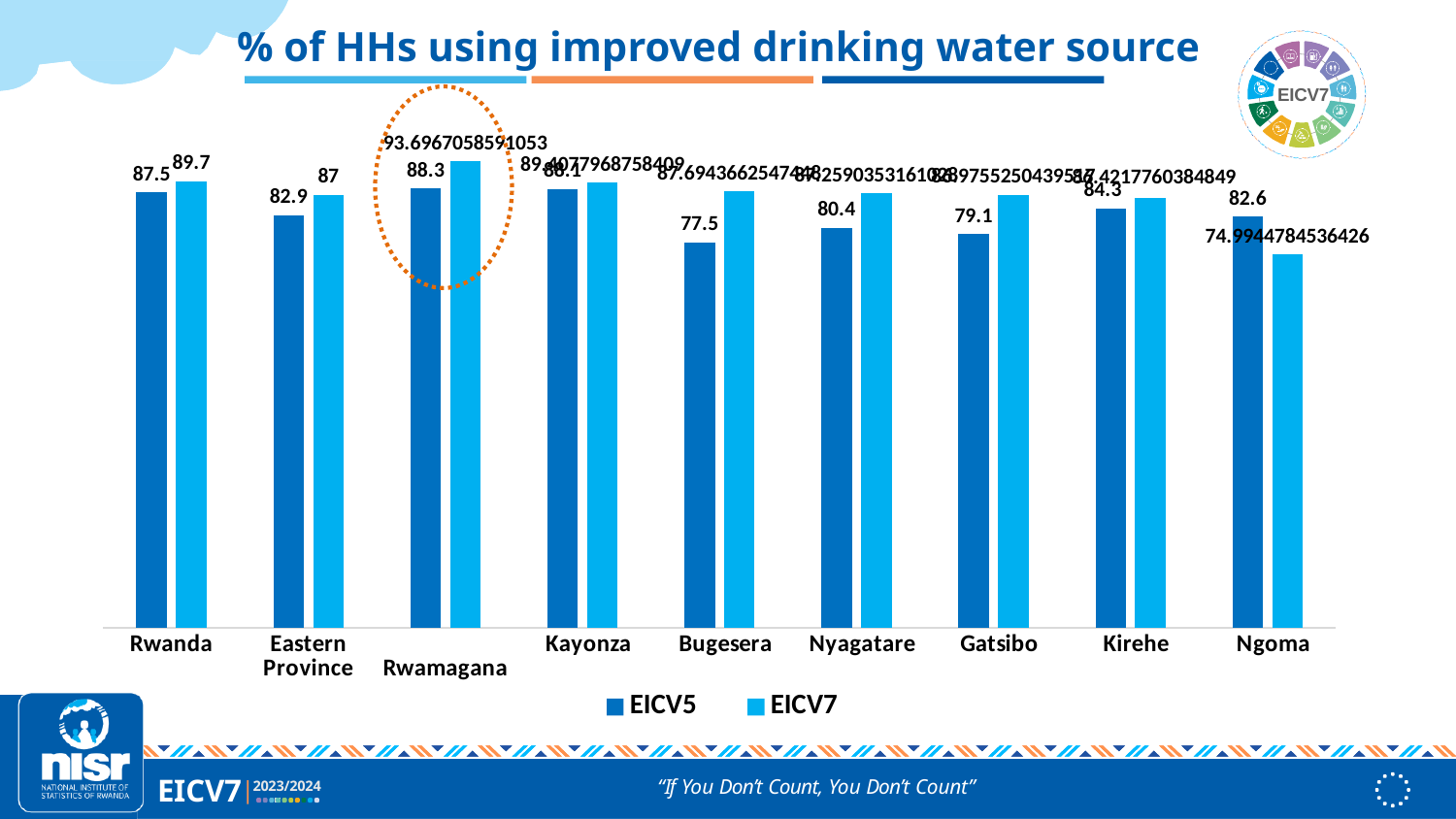
For Ngoma, which is larger: the EICV5 value or the EICV7 value? EICV5 Which category has the highest EICV7 value? Rwamagana What is the EICV7 value for Rwamagana? 93.6967058591053 How many series does the legend list? 2 What is the title of the chart? % of HHs using improved drinking water source What is the difference between the EICV7 and EICV5 values for Rwanda? 2.2 What kind of chart is shown on the slide? bar chart What is the EICV7 value for Ngoma? 74.9944784536426 What is the EICV5 value for Rwanda? 87.5 What is the EICV5 value for Bugesera? 77.5 Which category has the lowest EICV5 value? Bugesera How many categories are shown on the x axis? 9